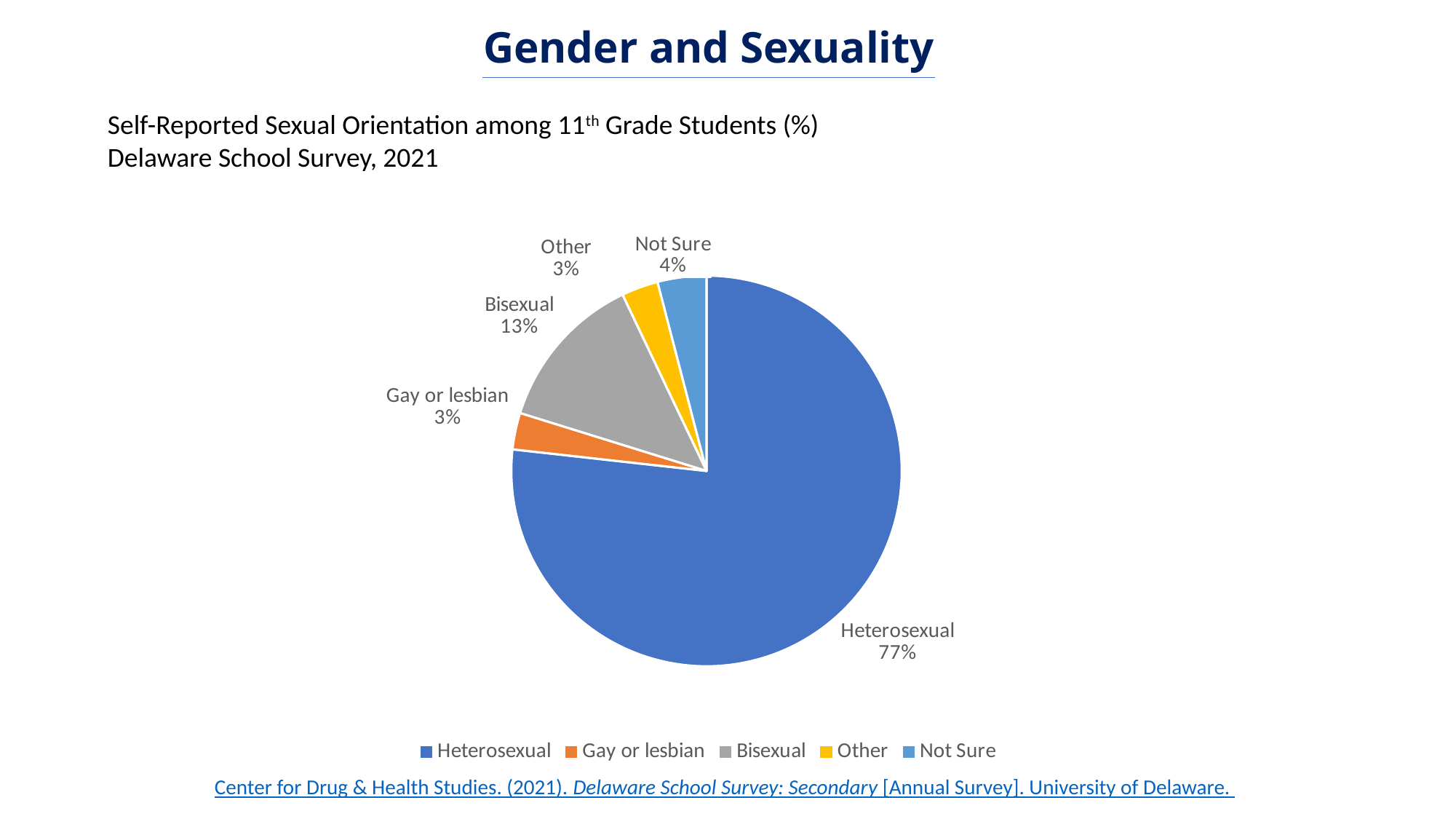
What type of chart is shown on the slide? Pie chart What is the difference in percentage points between Bisexual and Not Sure? 9 What percentage of students self-reported as Bisexual? 13% Which is larger, the share for Bisexual or the share for Not Sure? Bisexual Which category has the largest share of the pie? Heterosexual What percentage of 11th grade students self-reported as Heterosexual? 77% Which year's Delaware School Survey does the chart present? 2021 What percentage of students self-reported as Gay or lesbian? 3% What is the difference in percentage points between Heterosexual and Bisexual? 64 What colour is the Bisexual slice in the pie chart? Grey What percentage of students answered Not Sure? 4% How many categories are shown in the pie chart? 5